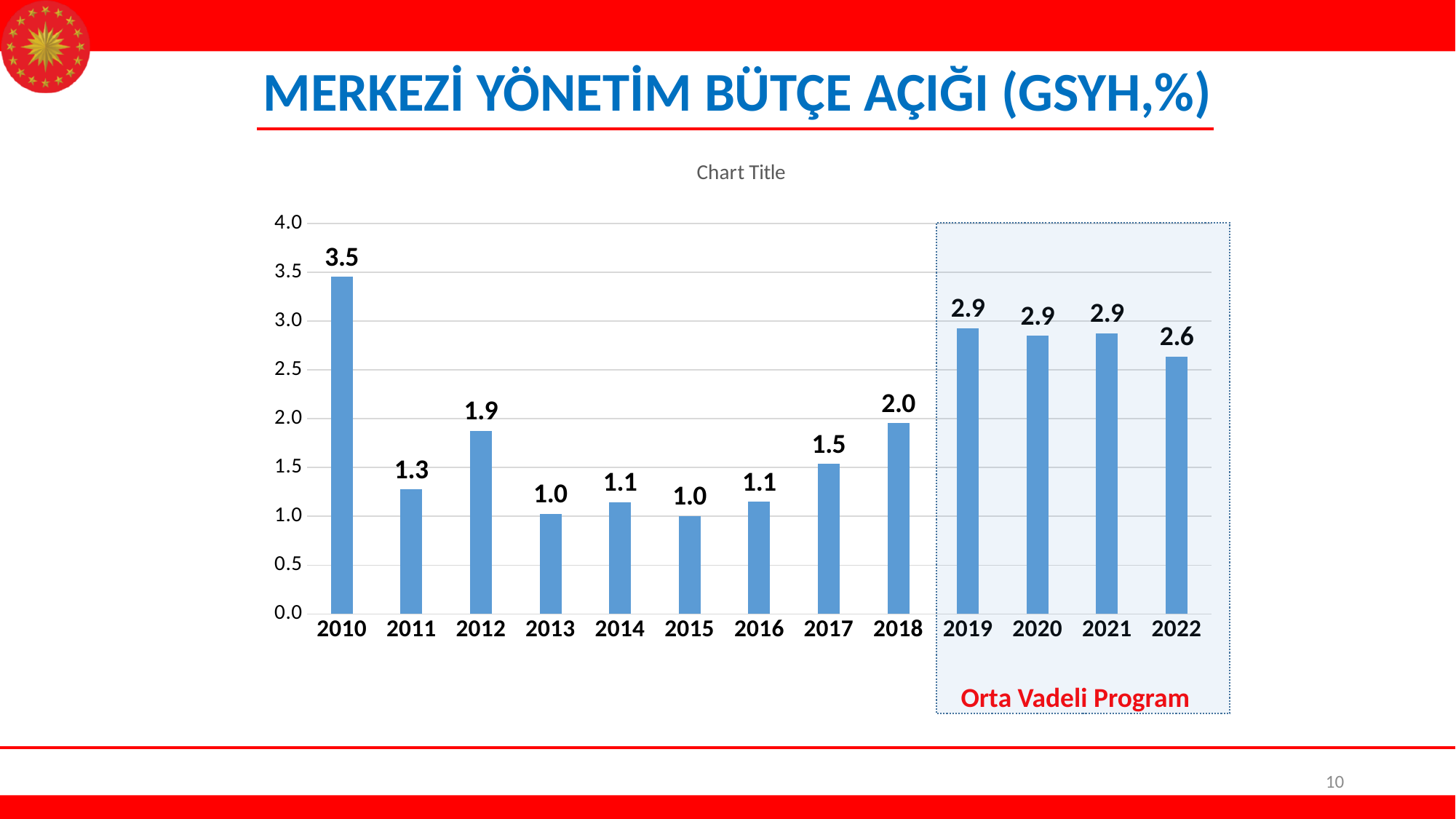
Which year has the highest value? 2010 Is the value for 2019 greater or less than 2.5? greater What label appears in the shaded box covering 2019 to 2022? Orta Vadeli Program Which is larger, the value for 2012 or the value for 2017? 2012 What is the difference between the values for 2010 and 2018? 1.5 What is the value for 2010? 3.5 Do the values rise or fall from 2015 to 2019? rise What kind of chart is this? bar chart What is the value for 2017? 1.5 How many years are shown on the x axis? 13 What is the difference between the values for 2012 and 2011? 0.6 What is the value for 2022? 2.6